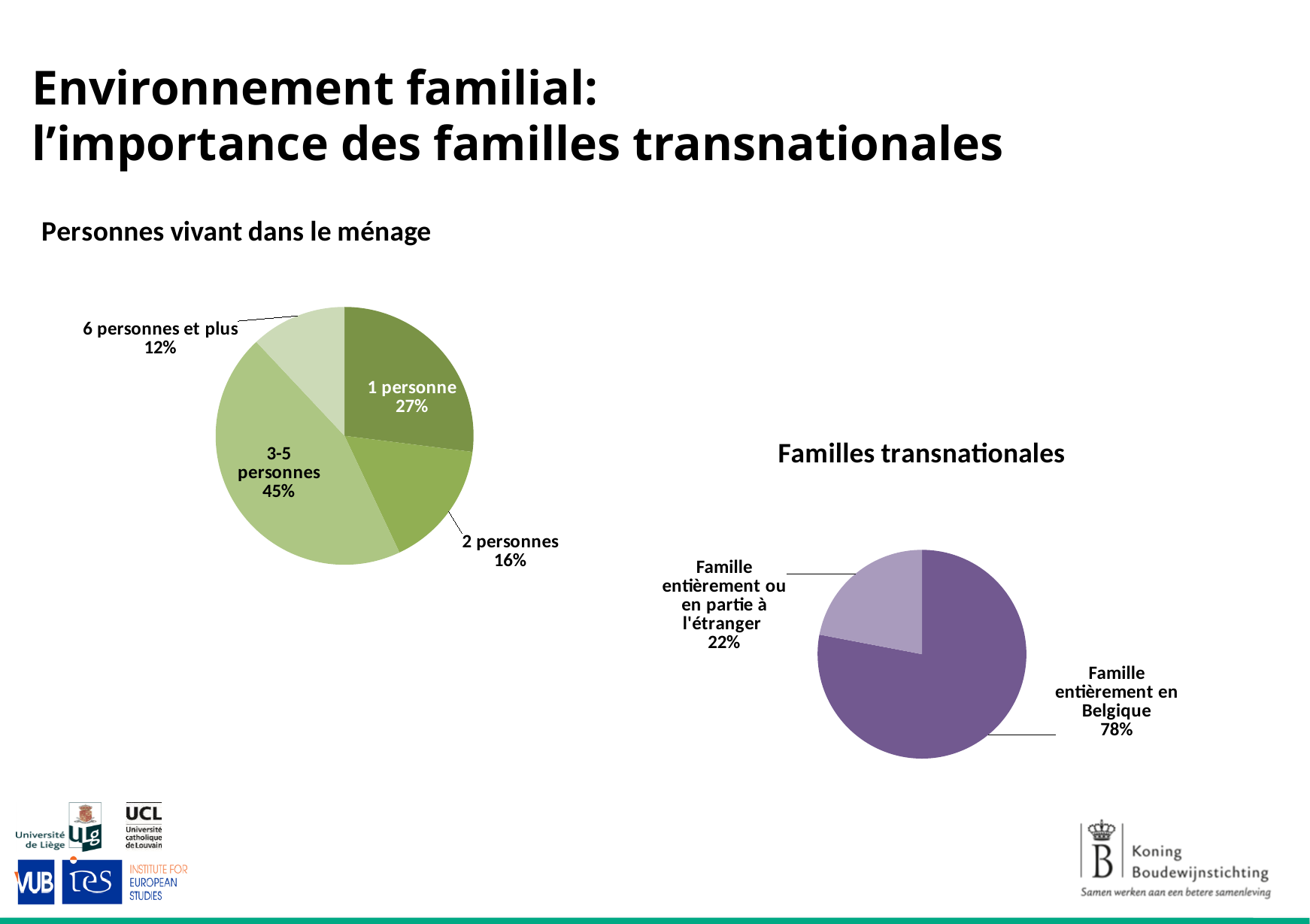
In the 'Personnes vivant dans le ménage' pie chart, what is the difference in percentage points between '3-5 personnes' and '1 personne'? 18 percentage points In the 'Familles transnationales' pie chart, what share is shown for 'Famille entièrement ou en partie à l'étranger'? 22% In the 'Personnes vivant dans le ménage' pie chart, what share is shown for '2 personnes'? 16% In the 'Personnes vivant dans le ménage' pie chart, what share is shown for '1 personne'? 27% In the 'Personnes vivant dans le ménage' pie chart, how many categories are shown? 4 What type of chart is used for 'Familles transnationales'? Pie chart In the 'Familles transnationales' pie chart, what share is shown for 'Famille entièrement en Belgique'? 78% In the 'Personnes vivant dans le ménage' pie chart, what share is shown for '6 personnes et plus'? 12% What is the title of the chart on the right side of the slide? Familles transnationales In the 'Personnes vivant dans le ménage' pie chart, which category has the smallest share? 6 personnes et plus In the 'Personnes vivant dans le ménage' pie chart, which category has the largest share? 3-5 personnes In the 'Familles transnationales' pie chart, which category is larger: 'Famille entièrement en Belgique' or 'Famille entièrement ou en partie à l'étranger'? Famille entièrement en Belgique